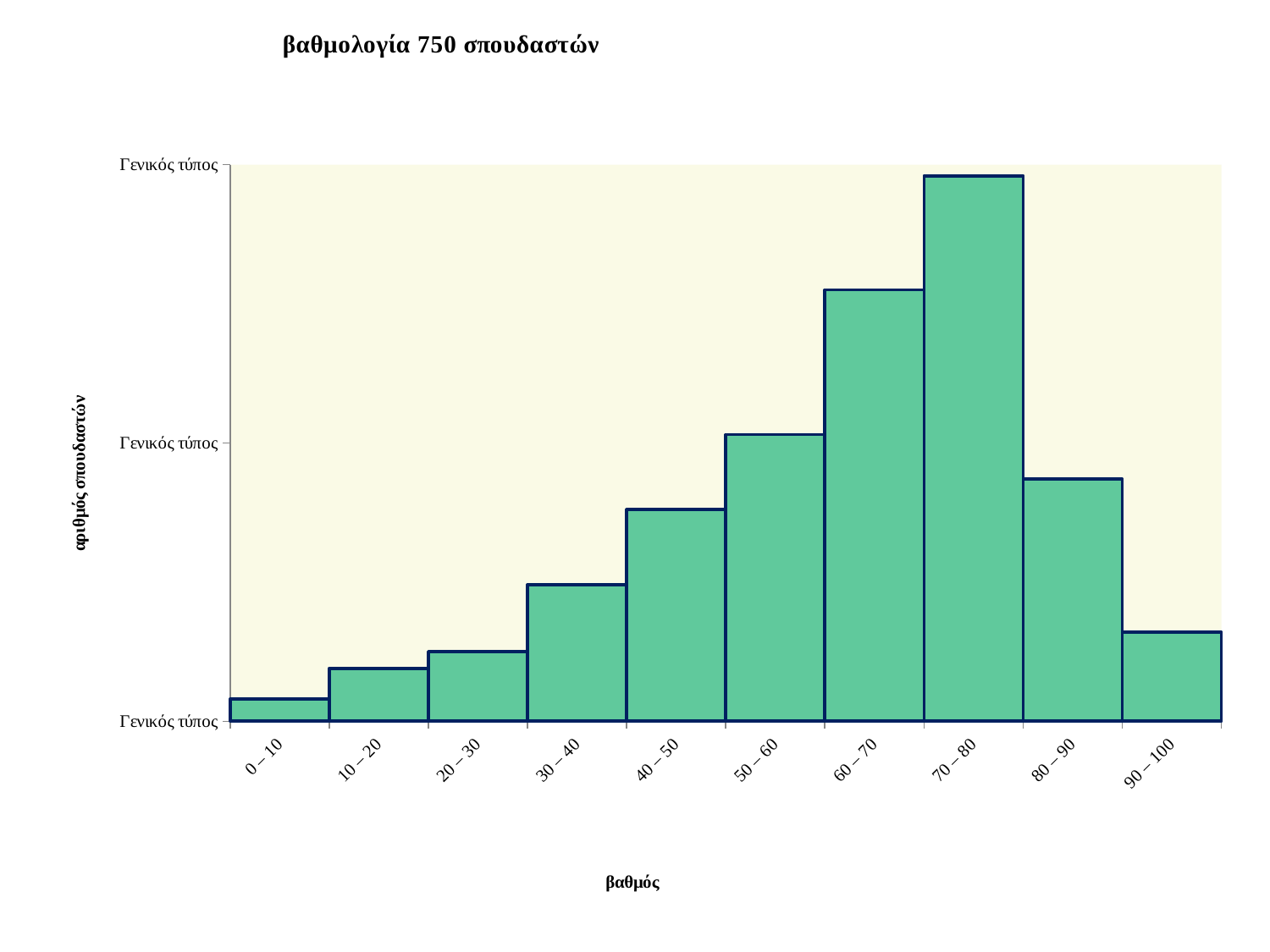
What is the title of the chart? βαθμολογία 750 σπουδαστών Which category has the larger value, 30 – 40 or 80 – 90? 80 – 90 How many grade categories are shown on the x axis? 10 Which grade category has the lowest number of students? 0 – 10 Do the values rise or fall from the 70 – 80 category to the 90 – 100 category? Fall Which category has the larger value, 60 – 70 or 80 – 90? 60 – 70 Which category has the larger value, 20 – 30 or 90 – 100? 90 – 100 Do the values rise or fall from the 0 – 10 category to the 70 – 80 category? Rise Which grade category has the highest number of students? 70 – 80 What is the label of the x axis? βαθμός What type of chart is shown on the slide? Bar chart